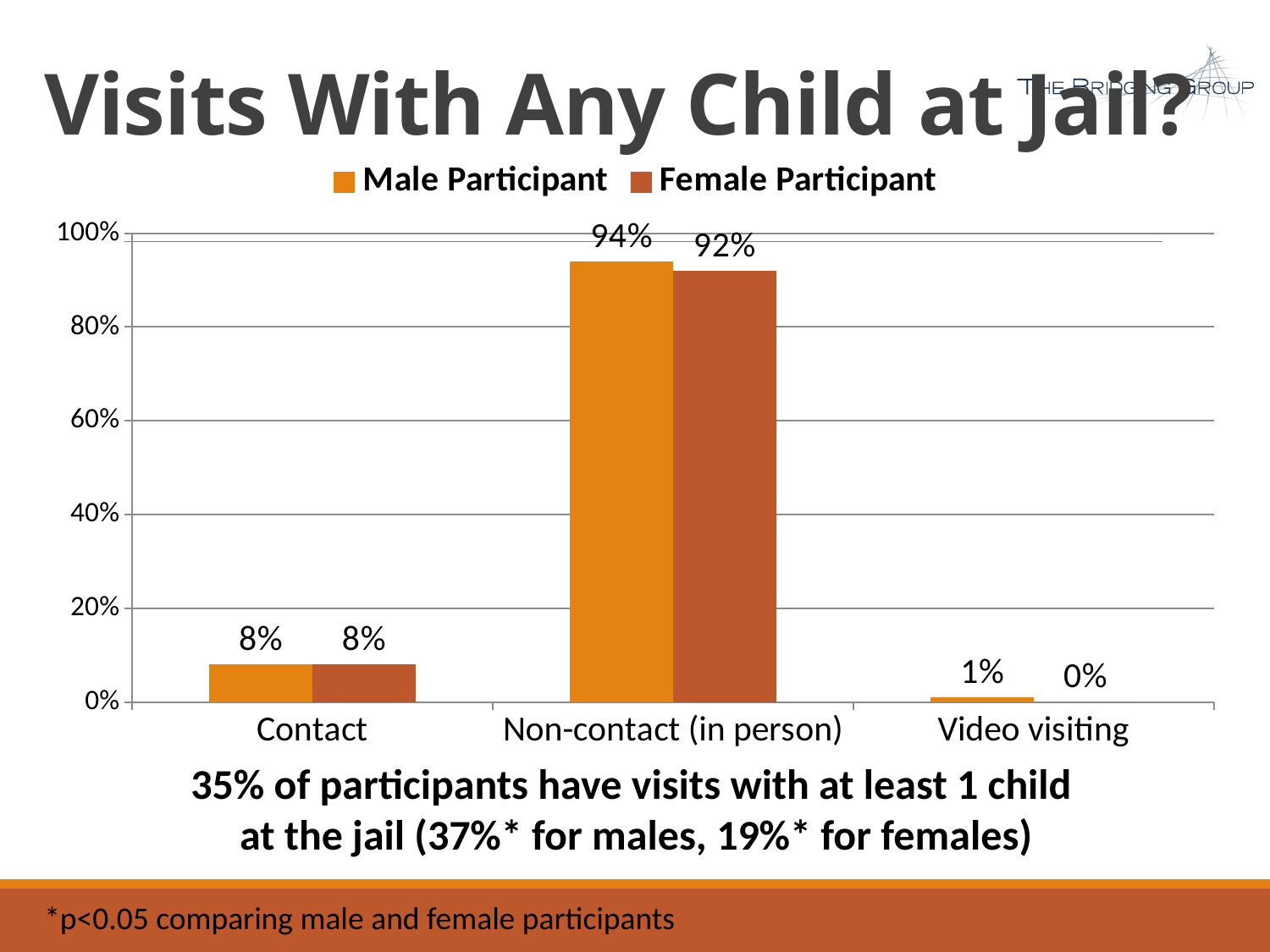
Which category has the highest value for Male Participant? Non-contact (in person) What is the difference between the Male Participant and Female Participant values in the Non-contact (in person) category? 2% What kind of chart is shown on the slide? Bar chart What is the value for Male Participant in the Non-contact (in person) category? 94% What is the value for Male Participant in the Contact category? 8% How many series does the legend list? 2 Which is larger in the Video visiting category: Male Participant or Female Participant? Male Participant What is the title of the chart? Visits With Any Child at Jail? Which category has the lowest value for Female Participant? Video visiting How many categories are shown on the x axis? 3 What is the value for Female Participant in the Non-contact (in person) category? 92% What is the value for Female Participant in the Video visiting category? 0%